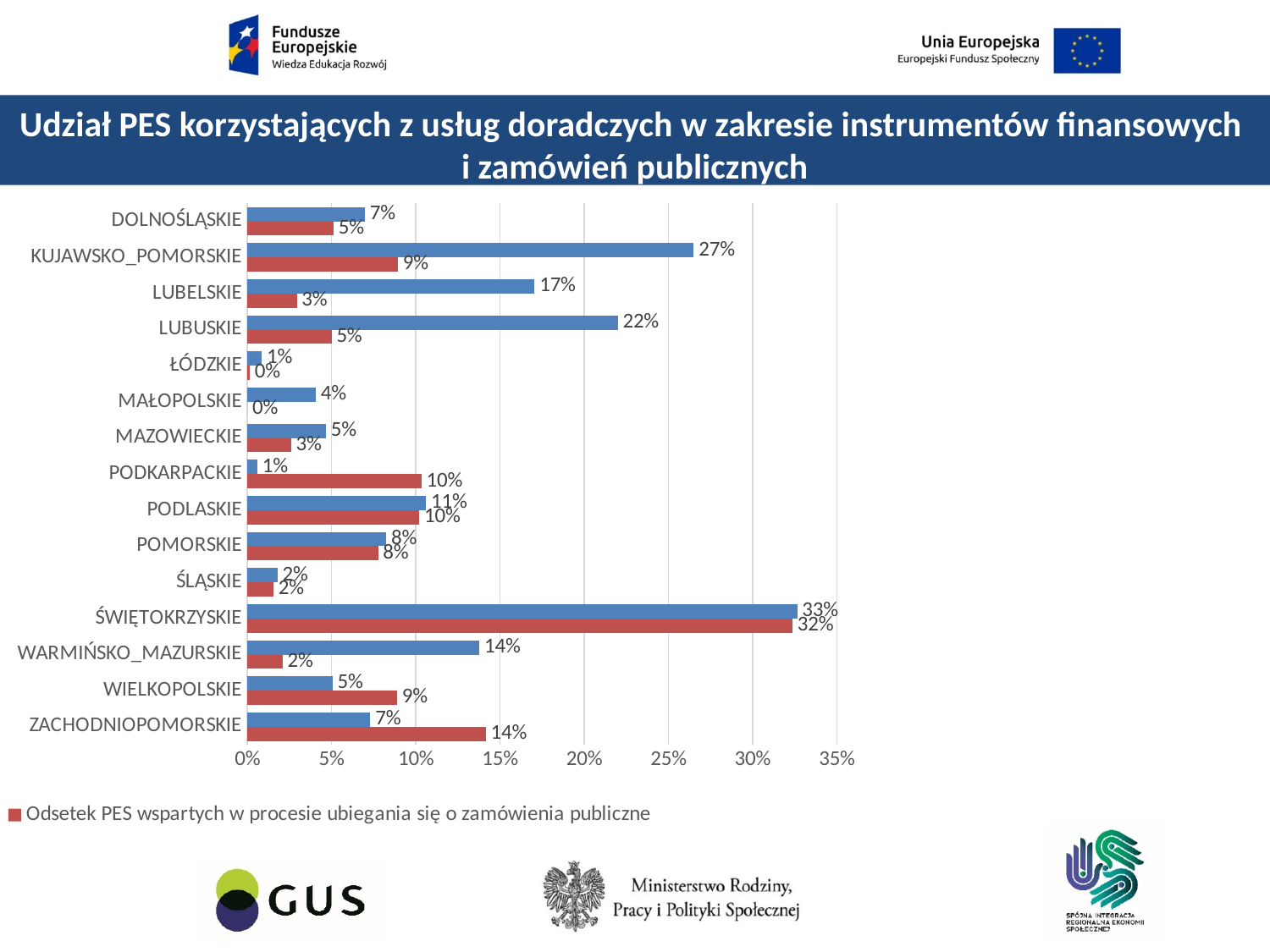
Which voivodeship has the highest value for the red series (Odsetek PES wspartych w procesie ubiegania się o zamówienia publiczne)? ŚWIĘTOKRZYSKIE What is the value of the blue bar for KUJAWSKO_POMORSKIE? 27% What is the value of the red bar (Odsetek PES wspartych w procesie ubiegania się o zamówienia publiczne) for ŚWIĘTOKRZYSKIE? 32% Is the blue bar for LUBELSKIE greater or less than 15%? greater Which voivodeship has the highest value for the blue series? ŚWIĘTOKRZYSKIE How many voivodeships (categories) are shown on the chart? 15 What type of chart is shown on the slide? bar chart What is the legend entry shown below the chart? Odsetek PES wspartych w procesie ubiegania się o zamówienia publiczne What is the value of the red bar for ZACHODNIOPOMORSKIE? 14% What is the difference between the blue bar and the red bar for LUBUSKIE? 17% What is the difference between the blue bar values of KUJAWSKO_POMORSKIE and WARMIŃSKO_MAZURSKIE? 13% For PODKARPACKIE, which is larger: the blue bar or the red bar? the red bar